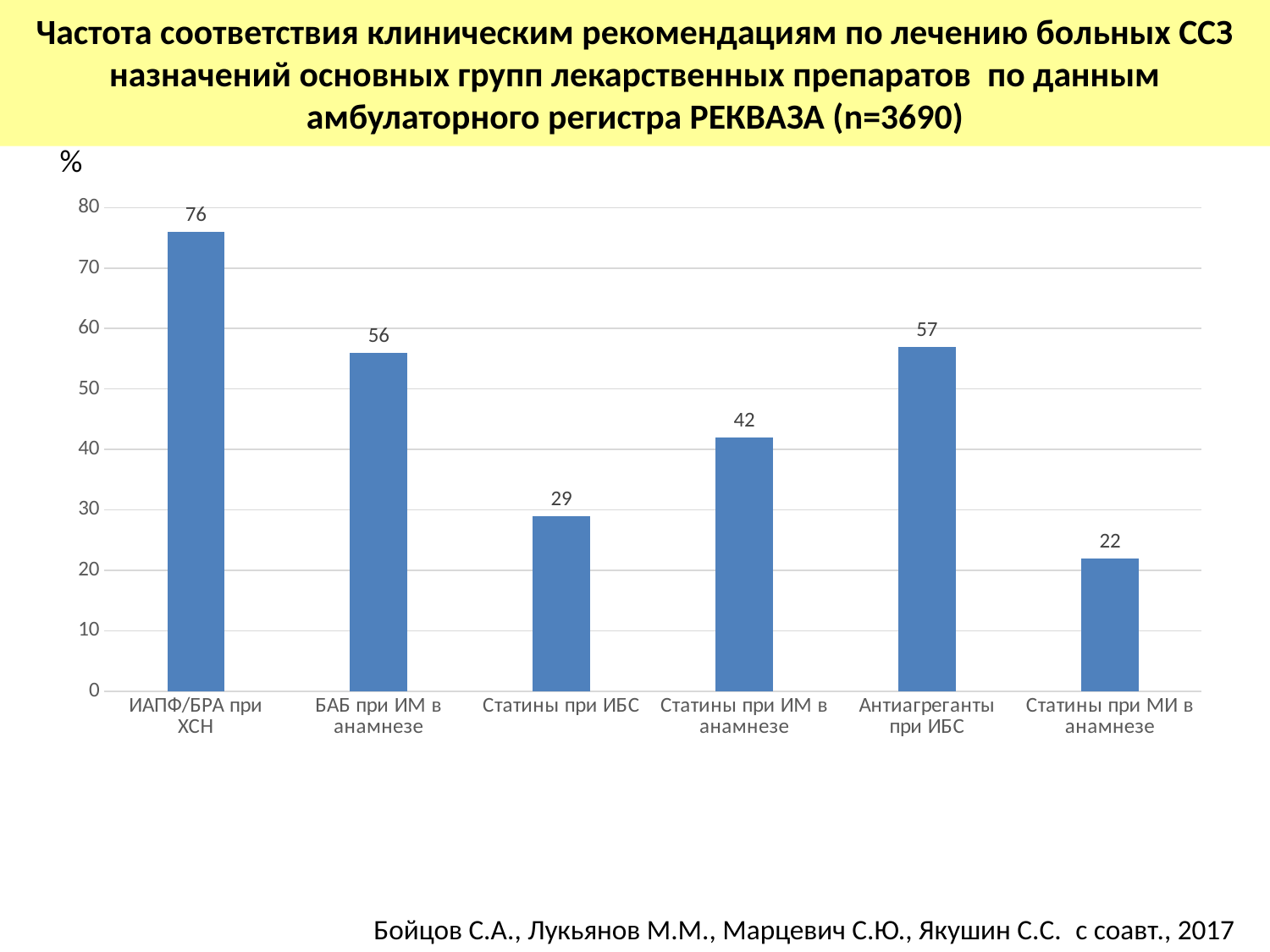
How many categories are shown on the chart? 6 What unit label is shown above the vertical axis? % Is the value for Антиагреганты при ИБС greater or less than 50? greater What is the value for Статины при МИ в анамнезе? 22 Which is larger: the value for Статины при ИМ в анамнезе or the value for Статины при ИБС? Статины при ИМ в анамнезе What is the value for Антиагреганты при ИБС? 57 What is the difference between the values for ИАПФ/БРА при ХСН and БАБ при ИМ в анамнезе? 20 Which category has the highest value? ИАПФ/БРА при ХСН What is the value for Статины при ИБС? 29 What is the value for ИАПФ/БРА при ХСН? 76 What kind of chart is shown on the slide? bar chart Which category has the lowest value? Статины при МИ в анамнезе